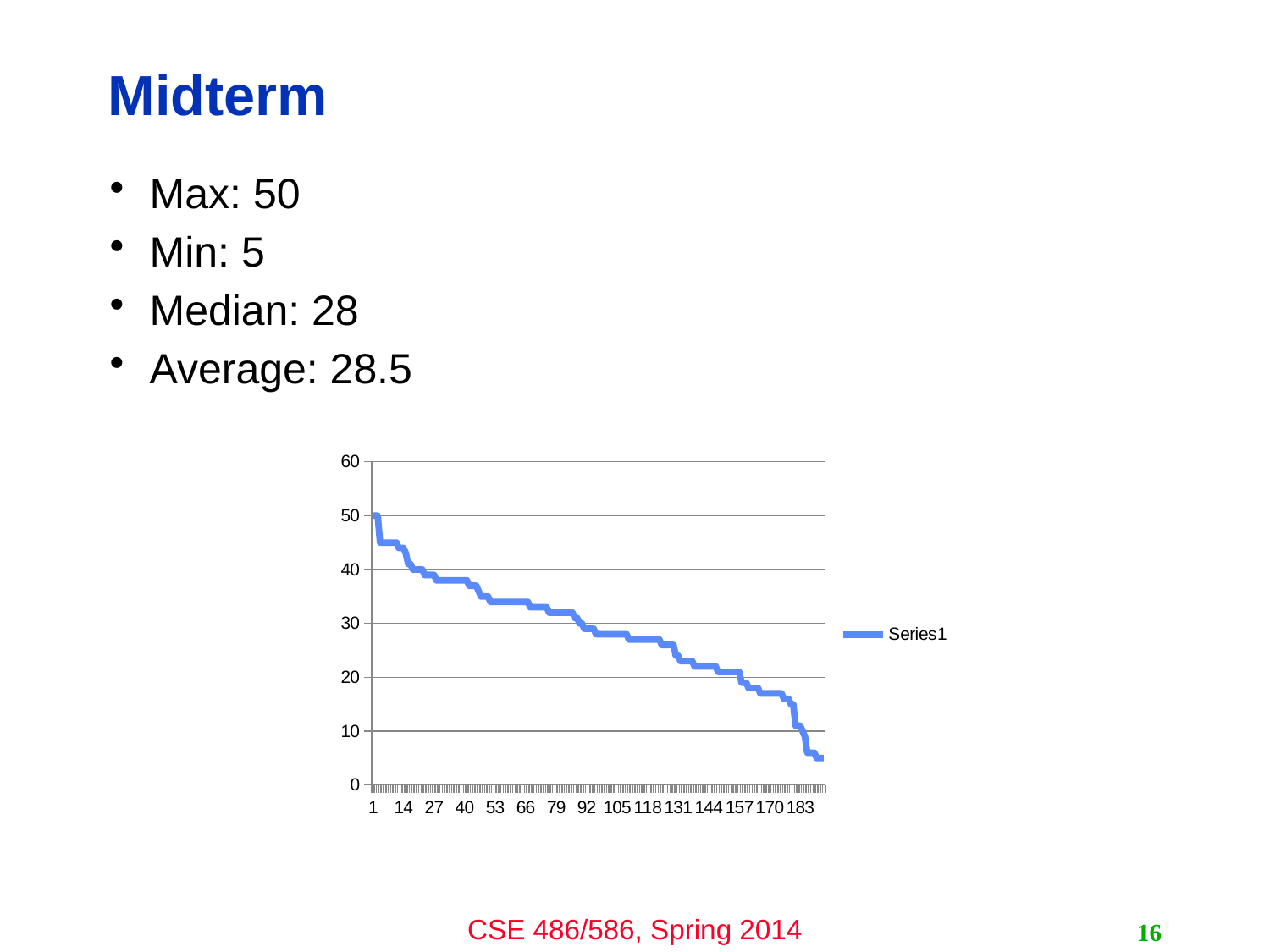
What is the highest tick value shown on the chart's y axis? 60 What is the lowest value plotted on the chart? 5 What is the name of the series shown in the chart's legend? Series1 Is the value at x = 1 greater or less than 40? greater Is the value at x = 92 greater or less than 40? less Is the value at x = 27 greater or less than 30? greater What is the highest value plotted on the chart? 50 What kind of chart is shown on the slide? line chart Do the plotted values rise or fall as you move from left to right along the x axis? fall How many series does the chart's legend list? 1